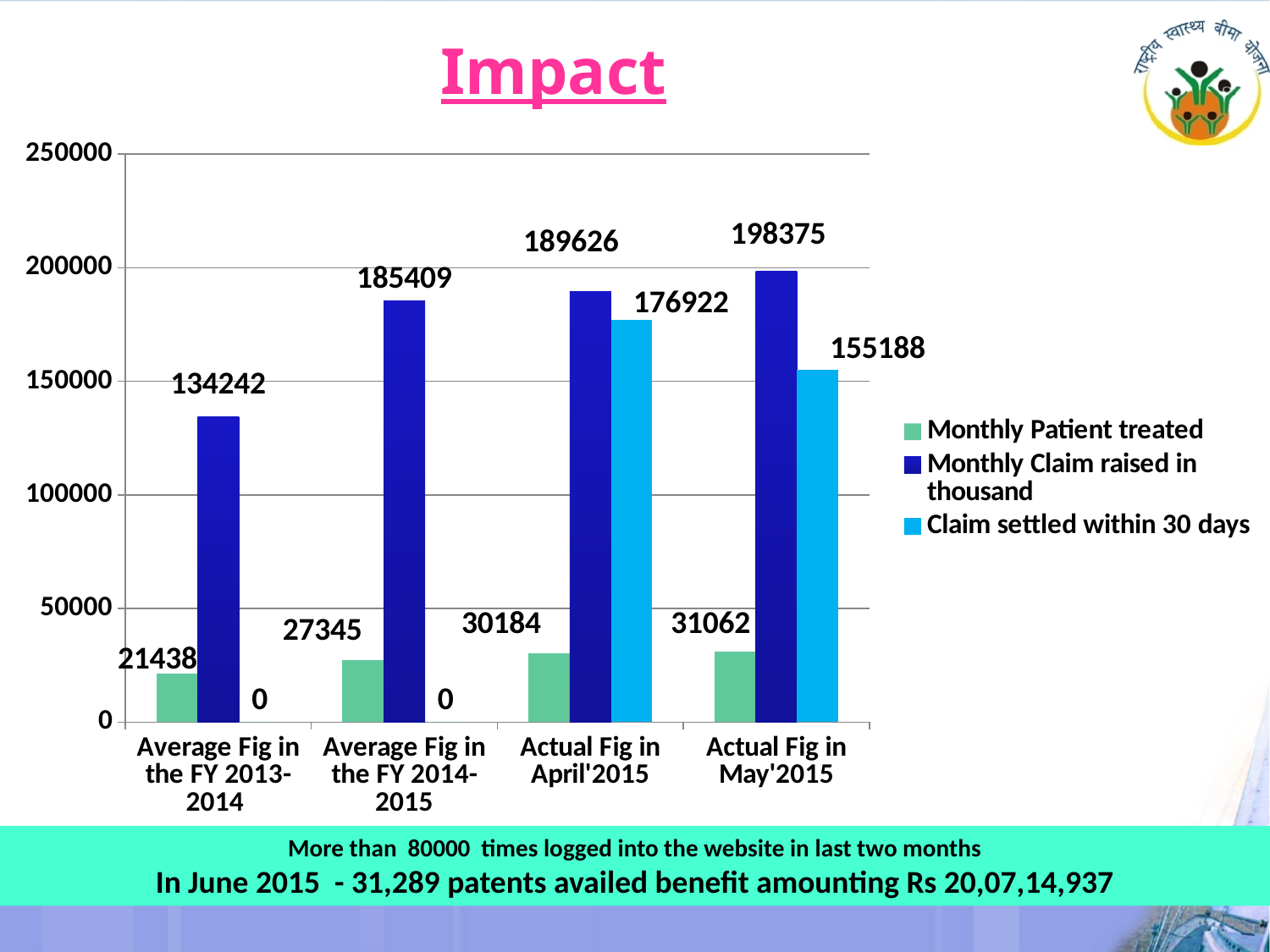
How many series does the legend list? 3 What is the value of Claim settled within 30 days for Actual Fig in April'2015? 176922 What is the value of Monthly Patient treated for Average Fig in the FY 2013-2014? 21438 Which category has the lowest value for Monthly Patient treated? Average Fig in the FY 2013-2014 Is the value of Monthly Claim raised in thousand for Average Fig in the FY 2013-2014 greater or less than 150000? less What is the difference between Monthly Claim raised in thousand for Actual Fig in May'2015 and Actual Fig in April'2015? 8749 What kind of chart is shown on the slide? bar chart Which is larger: Claim settled within 30 days for Actual Fig in April'2015 or for Actual Fig in May'2015? Actual Fig in April'2015 How many categories are shown on the x axis? 4 Does the Monthly Patient treated series rise or fall across the categories from left to right? rise What is the value of Monthly Claim raised in thousand for Actual Fig in May'2015? 198375 Which category has the highest value for Monthly Claim raised in thousand? Actual Fig in May'2015